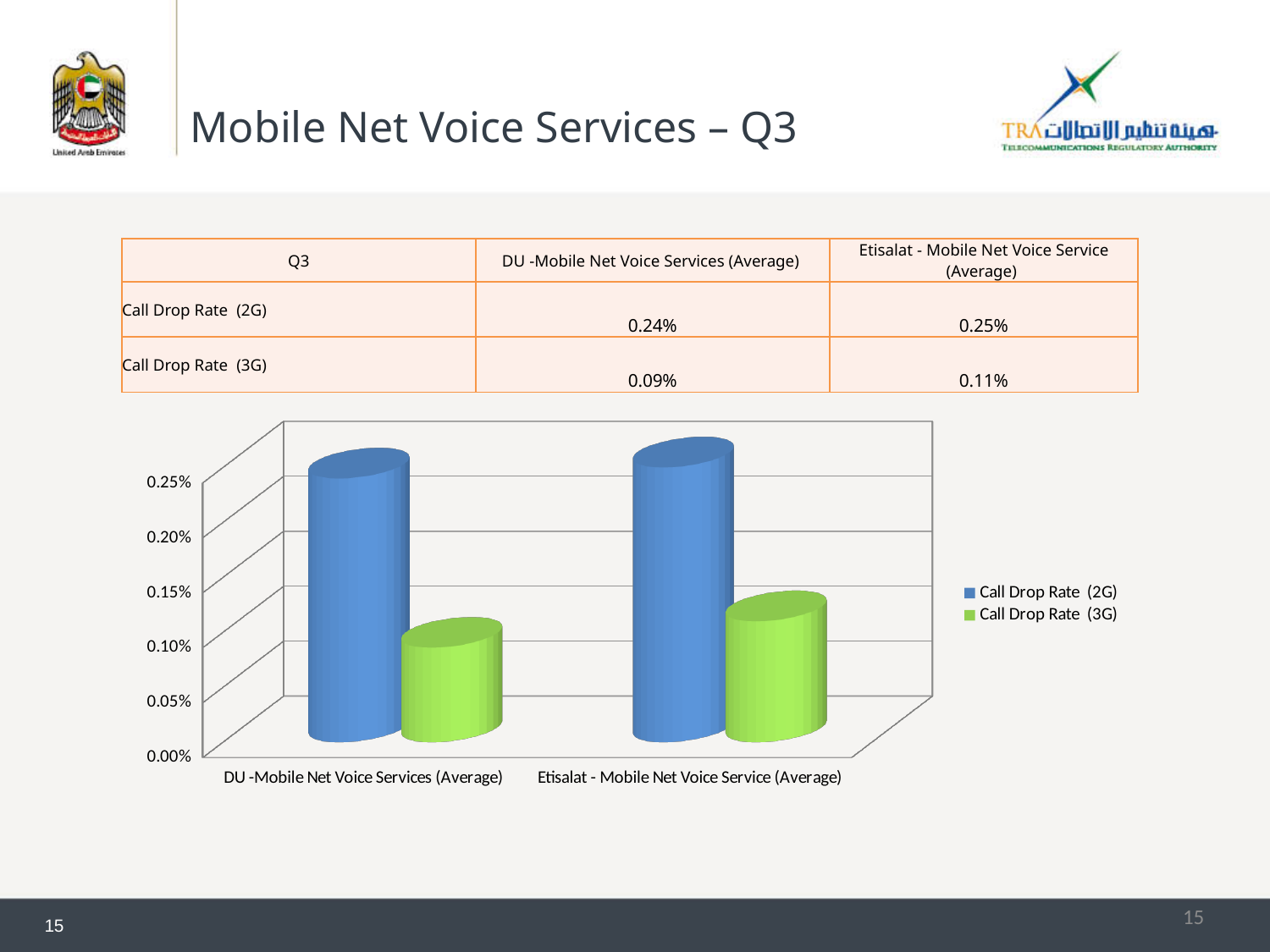
What is the Call Drop Rate (3G) for DU - Mobile Net Voice Services (Average)? 0.09% What is the difference in Call Drop Rate (3G) between Etisalat and DU? 0.02% How many operator categories are shown on the x axis of the chart? 2 What is the Call Drop Rate (2G) for Etisalat - Mobile Net Voice Service (Average)? 0.25% What is the Call Drop Rate (3G) for Etisalat - Mobile Net Voice Service (Average)? 0.11% What kind of chart is shown on the slide? Bar chart Is the Call Drop Rate (3G) for DU - Mobile Net Voice Services (Average) greater or less than 0.10%? less How many series does the chart legend list? 2 Is the Call Drop Rate (2G) for DU - Mobile Net Voice Services (Average) greater or less than 0.20%? greater What is the difference between the Call Drop Rate (2G) and Call Drop Rate (3G) for DU - Mobile Net Voice Services (Average)? 0.15% Which operator has the higher Call Drop Rate (3G)? Etisalat - Mobile Net Voice Service (Average) What is the Call Drop Rate (2G) for DU - Mobile Net Voice Services (Average)? 0.24%